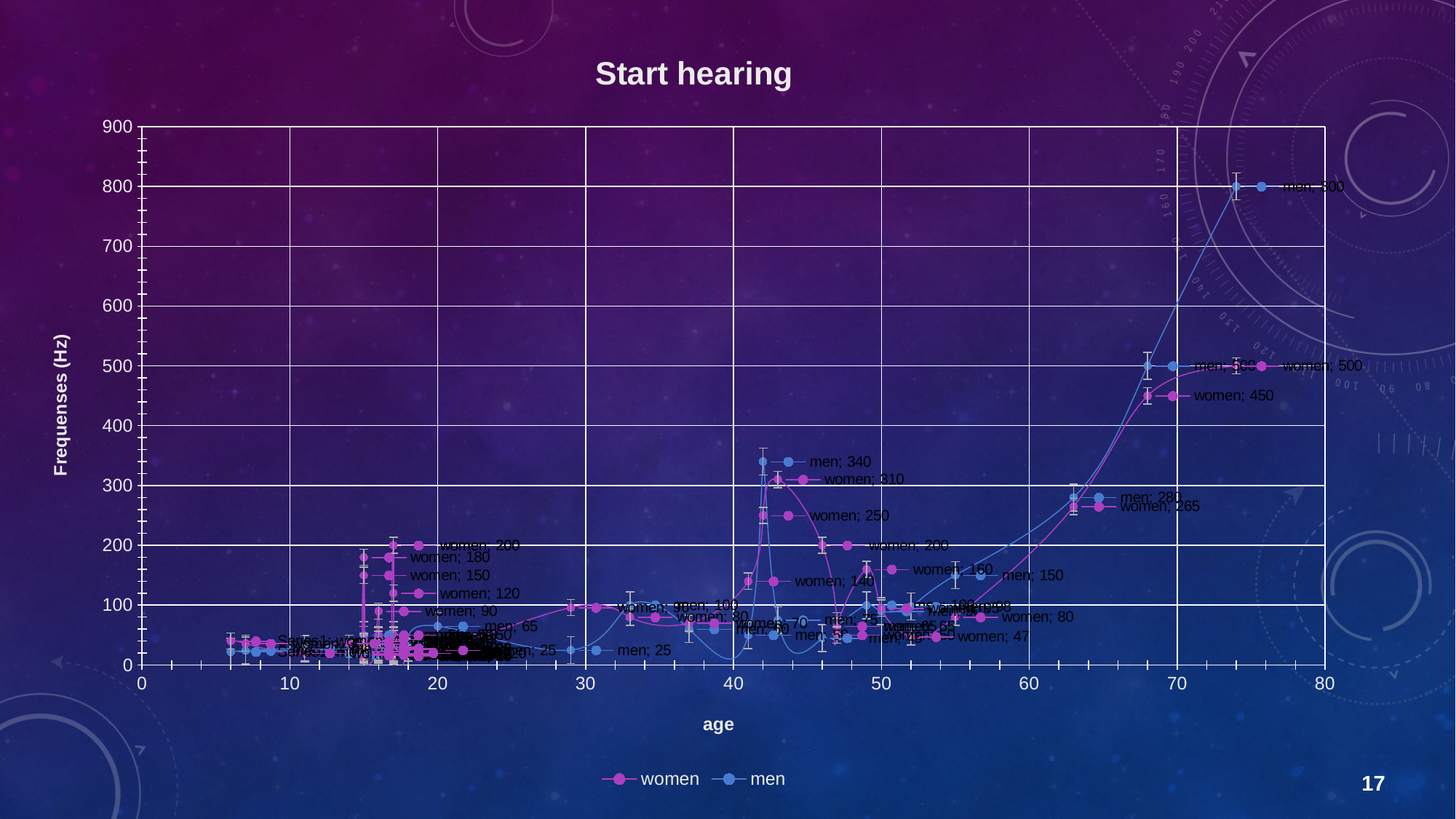
What is the highest frequency value labelled for the men series? 800 What is the title of the chart? Start hearing Is the highest men value greater or less than 700 Hz? greater What is the difference between the men value of 340 and the women value of 310 near age 42-43? 30 How many series does the legend list? 2 What is the label of the vertical axis? Frequenses (Hz) Near age 63, which is larger: the men value of 280 or the women value of 265? men; 280 What are the two series named in the legend? women and men What is the highest frequency value labelled for the women series? 500 Around age 42-43, which is larger: the men value of 340 or the women value of 310? men; 340 Which series reaches the highest frequency on the chart? men What is the difference between the highest men value (800) and the highest women value (500)? 300